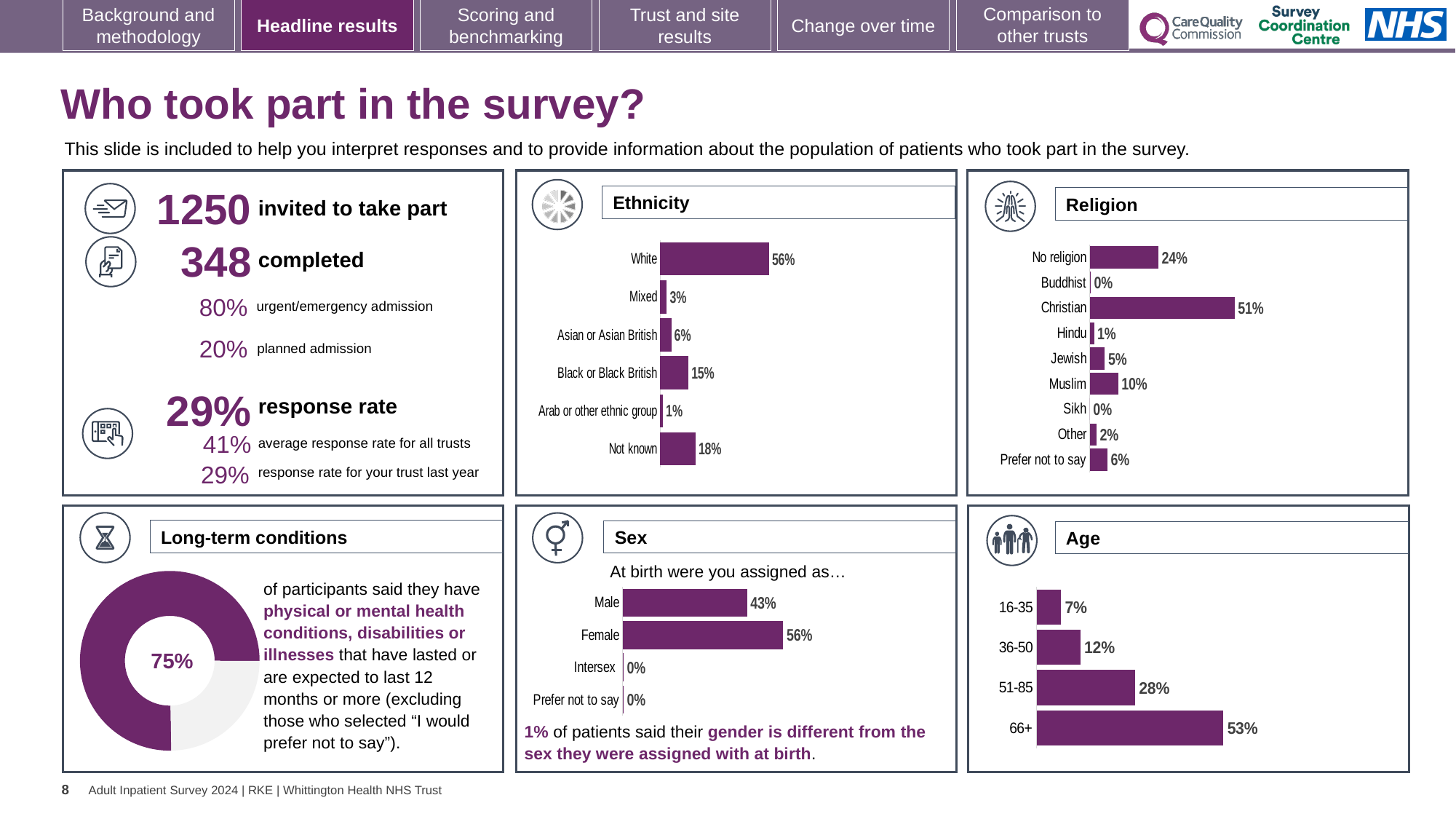
In the Age chart, do the values rise or fall as age increases from 16-35 to 66+? rise In the Ethnicity chart, how many categories are shown? 6 What kind of chart is used in the Long-term conditions panel? donut chart In the Religion chart, what is the difference between the Christian and No religion values? 27% In the Age chart, what percentage of respondents were aged 66+? 53% In the Ethnicity chart, what percentage of respondents were White? 56% In the Ethnicity chart, which category has the lowest value? Arab or other ethnic group In the Sex chart, what is the difference between the Female and Male values? 13% In the Religion chart, what percentage of respondents were Muslim? 10% In the Sex chart, which is larger, Male or Female? Female In the Religion chart, how many categories are listed? 9 In the Religion chart, which category has the highest value? Christian